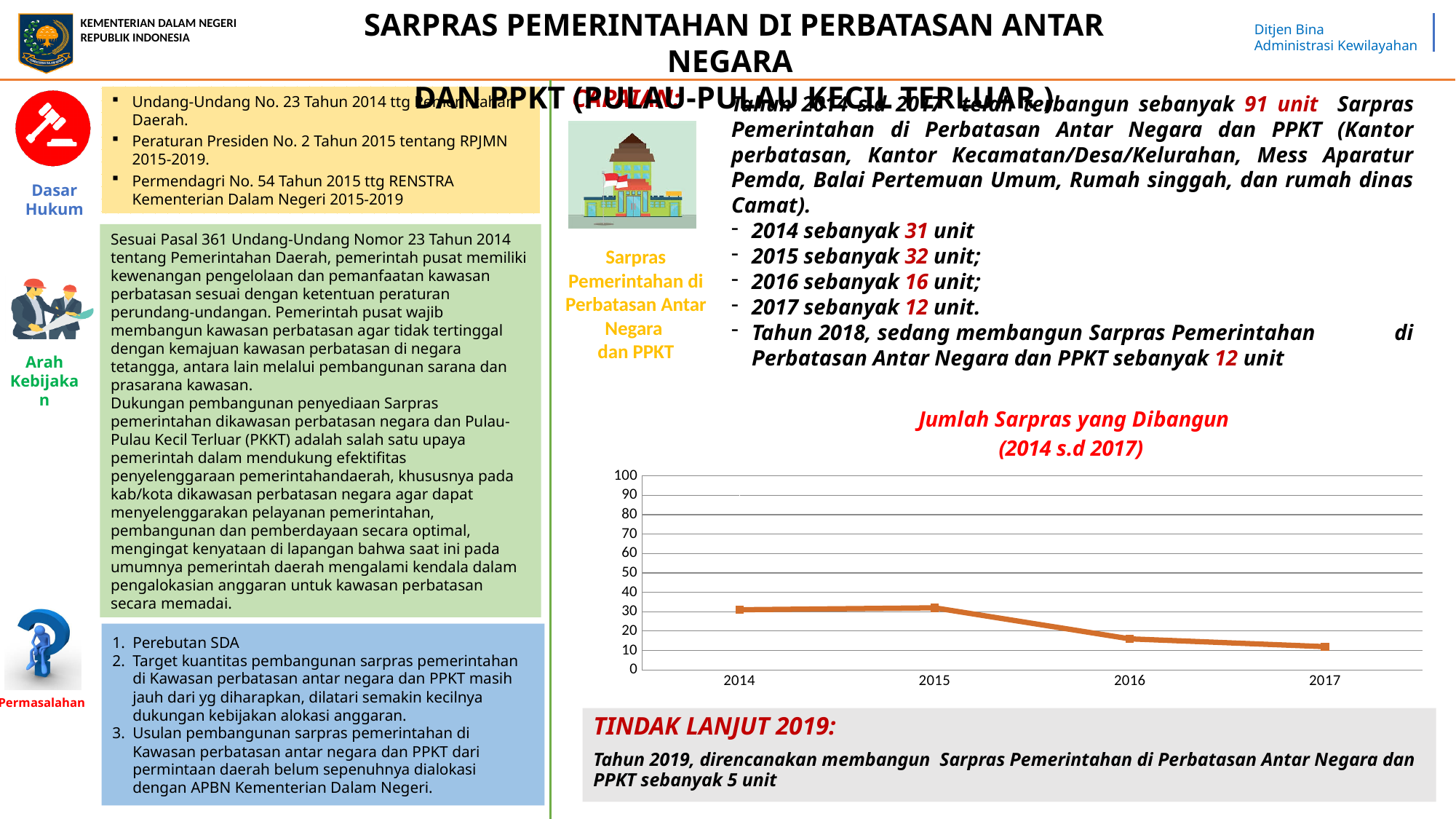
What kind of chart is shown under the title "Jumlah Sarpras yang Dibangun (2014 s.d 2017)"? line chart How many years are plotted on the x axis of the chart? 4 Is the value plotted for 2017 greater or less than 20? less What is the difference between the values for 2014 and 2016? 15 Do the plotted values generally rise or fall from 2015 to 2017? fall What is the title of the chart on the slide? Jumlah Sarpras yang Dibangun (2014 s.d 2017) Is the value plotted for 2015 greater or less than 20? greater According to the slide, how many units were built in 2016? 16 According to the slide, how many units were built in 2017? 12 Which year has the larger plotted value, 2014 or 2016? 2014 According to the slide, how many units were built in 2014? 31 What is the difference between the values for 2015 and 2017? 20